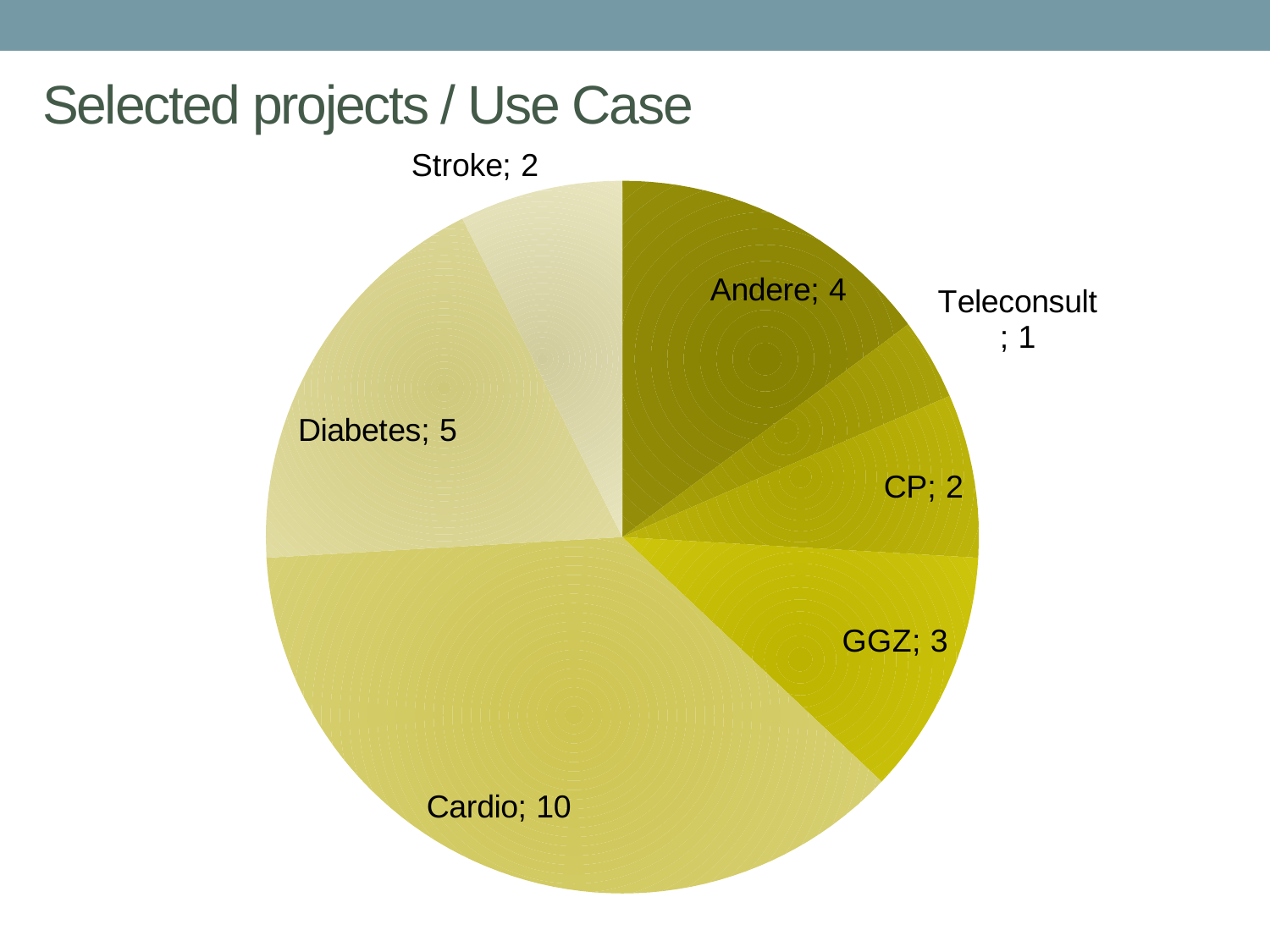
Which category has the smallest slice of the pie? Teleconsult What is the value for Teleconsult? 1 What is the difference between the values for Cardio and Diabetes? 5 How many categories are shown in the pie chart? 7 What is the value for GGZ? 3 Which category has the largest slice of the pie? Cardio What is the value for Diabetes? 5 What kind of chart is shown on the slide? pie chart Which is larger, the value for GGZ or the value for CP? GGZ What is the value for Andere? 4 What is the value for Cardio? 10 What is the title of the slide containing the pie chart? Selected projects / Use Case